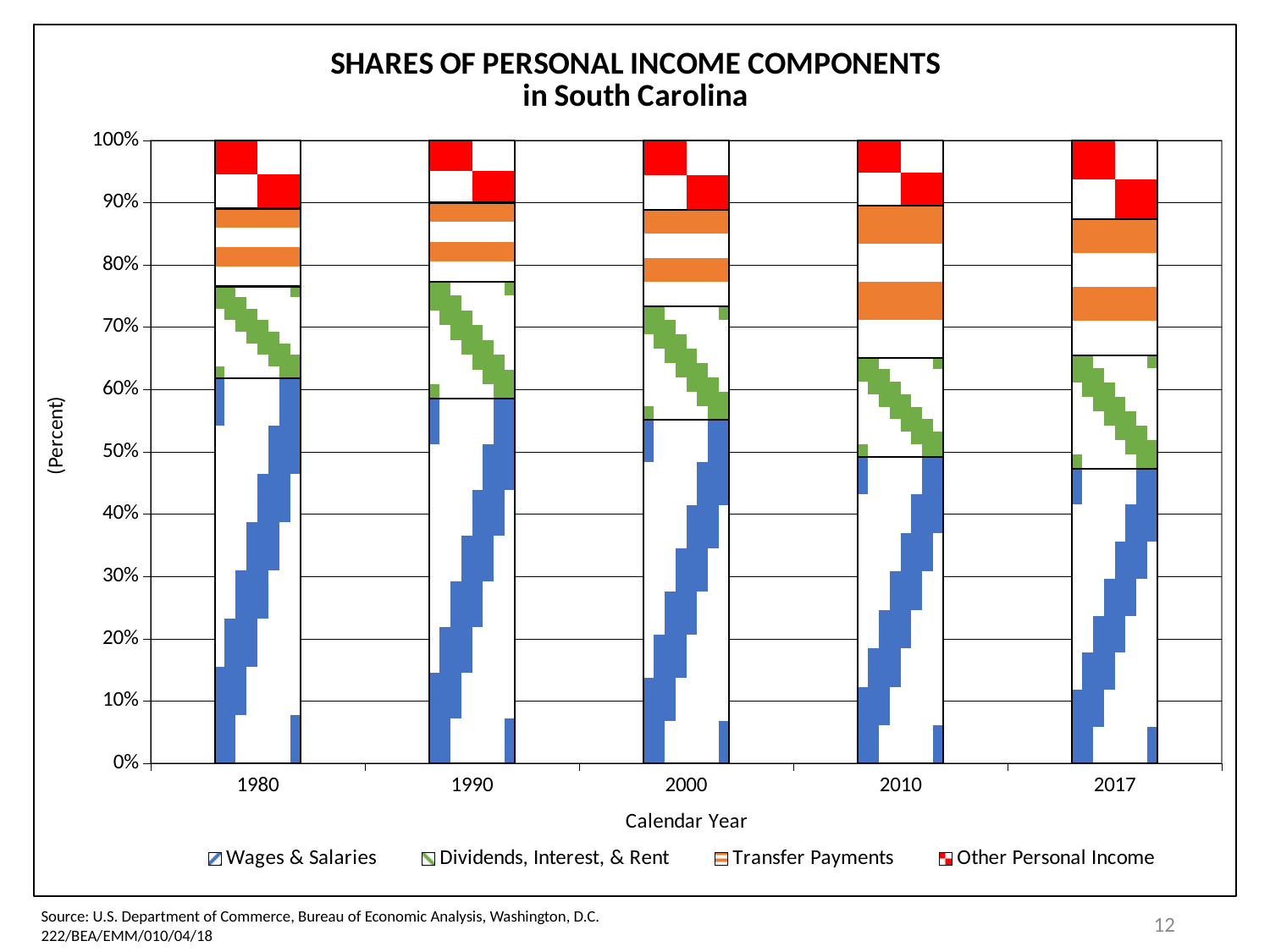
How many calendar years are shown on the x axis of the chart? 5 Is the Transfer Payments share larger in 1980 or in 2010? 2010 Is the Wages & Salaries share in 2000 greater or less than 50%? greater Is the Wages & Salaries share in 2017 greater or less than 50%? less How many series does the chart's legend list? 4 What kind of chart is shown on the slide? Stacked bar chart Which year has the highest Wages & Salaries share? 1980 Is the Wages & Salaries share in 1980 greater or less than 60%? greater Is the Wages & Salaries share larger in 1980 or in 2017? 1980 Which series is shown in red in the legend? Other Personal Income Does the Wages & Salaries share rise or fall from 1980 to 2017? Fall What is the label of the x axis? Calendar Year